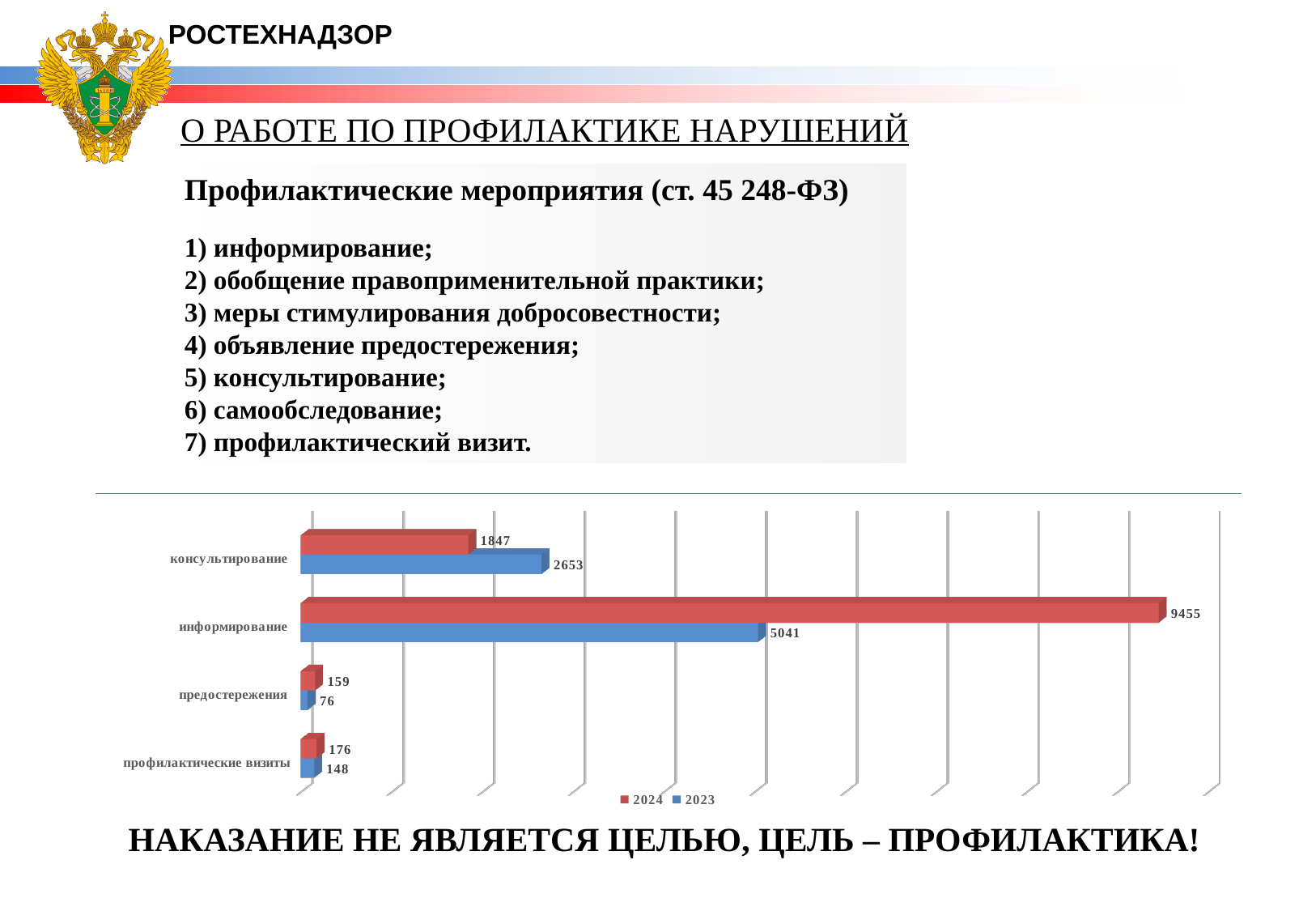
Which category has the highest value in the 2024 series? информирование How many series does the legend list? 2 Which is larger for консультирование: the 2024 value or the 2023 value? 2023 What kind of chart is shown on the slide? bar chart How many categories are shown on the chart? 4 Which category has the lowest value in the 2023 series? предостережения What is the value for профилактические визиты in 2024? 176 What is the difference between the 2024 and 2023 values for информирование? 4414 What is the value for информирование in 2024? 9455 What is the value for предостережения in 2023? 76 What is the difference between the 2023 and 2024 values for консультирование? 806 What is the value for консультирование in 2023? 2653